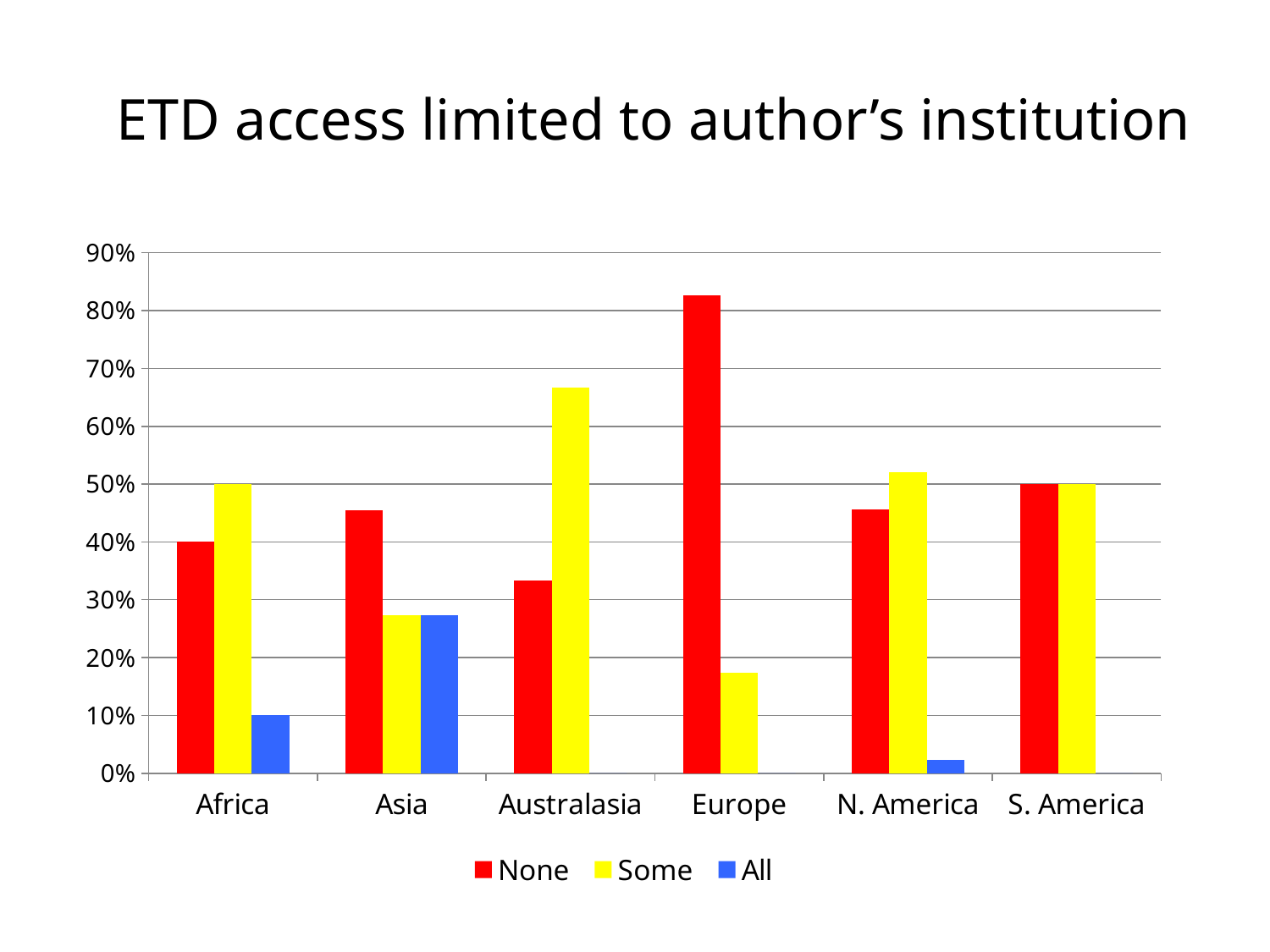
What is the value of the All series for Africa? 10% How many series does the legend list? 3 Which is larger for Asia, the None series or the Some series? None What is the title of the chart? ETD access limited to author's institution What type of chart is shown on the slide? bar chart What is the value of the None series for S. America? 50% Is the value of the None series for Europe greater or less than 80%? greater What is the value of the Some series for Africa? 50% Which region has the highest value for the None series? Europe How many regions are shown on the x axis? 6 Is the value of the Some series for Europe greater or less than 20%? less Which region has the highest value for the Some series? Australasia